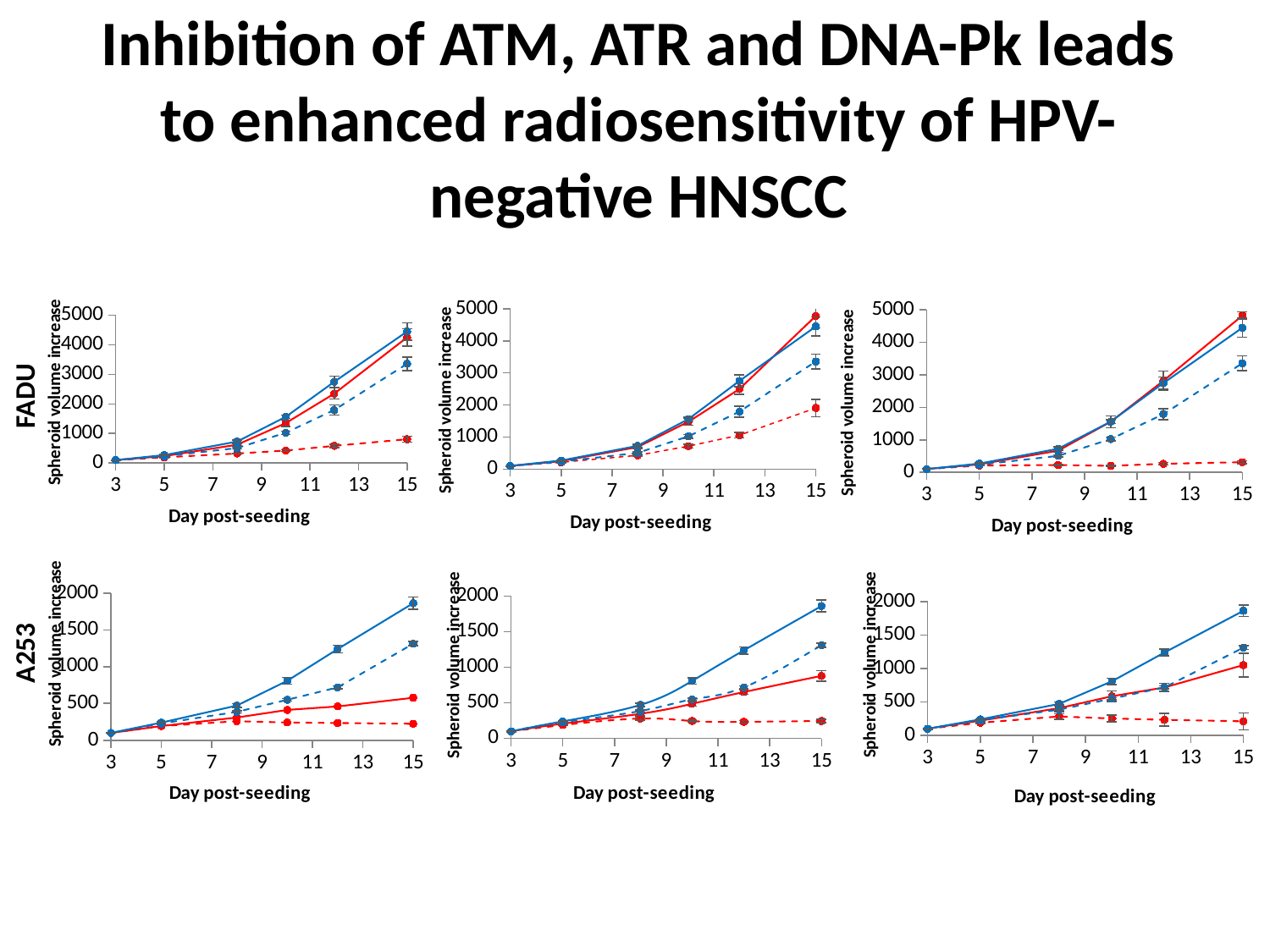
In the top-left chart (FADU row, left), is the value of the solid blue line at day 15 greater or less than 4000? greater What is the x-axis label of the bottom-left chart (A253 row, left)? Day post-seeding In the bottom-left chart (A253 row, left), is the value of the solid blue line at day 15 greater or less than 1500? greater How many charts are shown on the slide? 6 In the top-left chart (FADU row, left), how many data points does each line have along the x axis? 6 In the bottom-left chart (A253 row, left), at day 15, which is larger: the solid blue line or the solid red line? the solid blue line In the top-left chart (FADU row, left), which line has the lowest value at day 15? the dashed red line What is the y-axis label of the top-middle chart (FADU row, middle)? Spheroid volume increase What kind of chart is the top-left chart (FADU row, left)? line chart In the top-left chart (FADU row, left), is the value of the dashed red line at day 15 greater or less than 1000? less